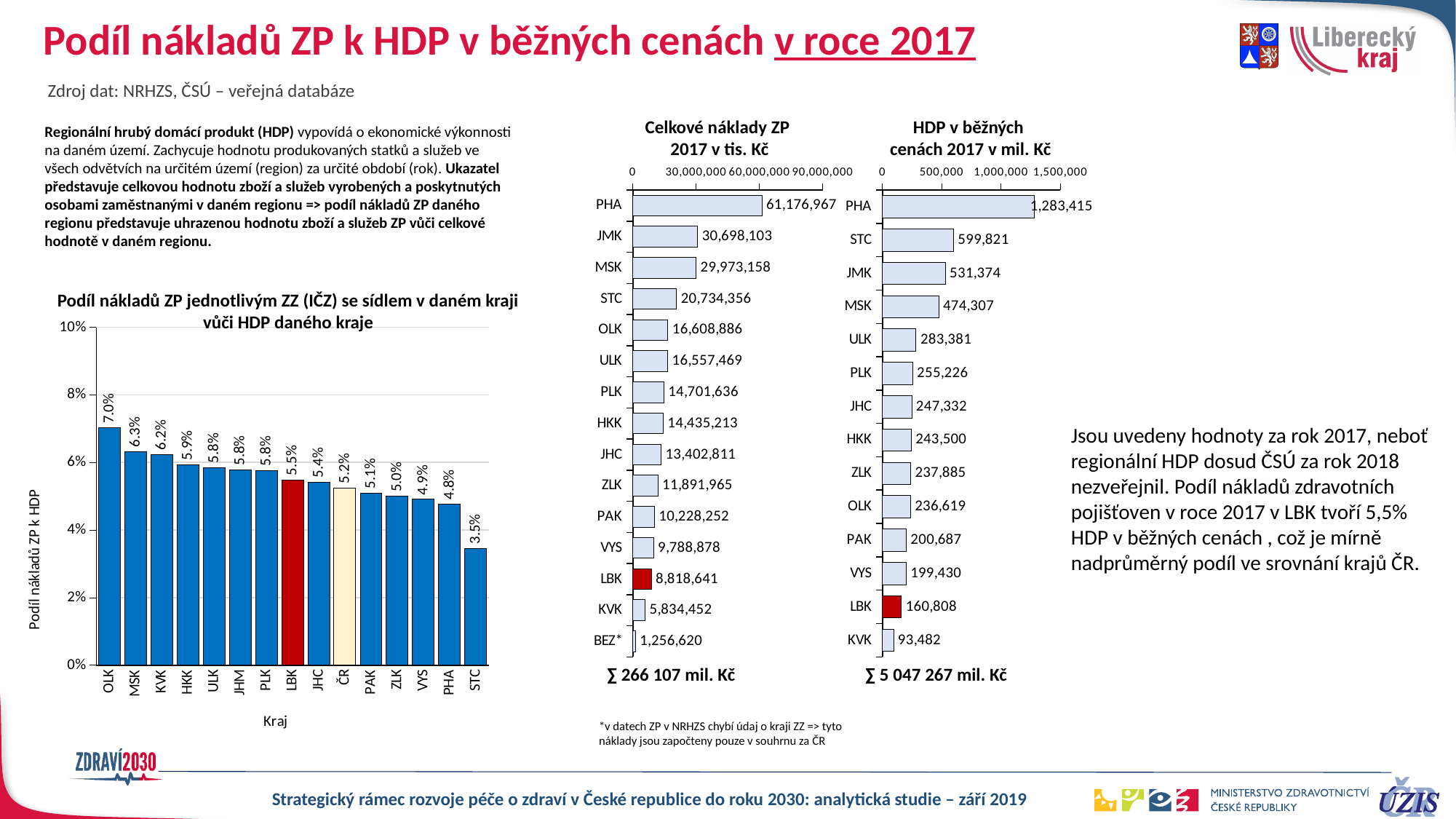
In the chart 'HDP v běžných cenách 2017 v mil. Kč', what is the value for STC? 599,821 In the chart 'Celkové náklady ZP 2017 v tis. Kč', which category has the highest value? PHA In the chart 'Celkové náklady ZP 2017 v tis. Kč', what is the value for LBK? 8,818,641 In the chart 'Podíl nákladů ZP jednotlivým ZZ (IČZ) se sídlem v daném kraji vůči HDP daného kraje', how many bars are shown? 15 What kind of chart is 'Celkové náklady ZP 2017 v tis. Kč'? Bar chart In the chart 'Podíl nákladů ZP jednotlivým ZZ (IČZ) se sídlem v daném kraji vůči HDP daného kraje', which kraj has the highest value? OLK In the chart 'Celkové náklady ZP 2017 v tis. Kč', which is larger, the value for JMK or the value for MSK? JMK In the chart 'Podíl nákladů ZP jednotlivým ZZ (IČZ) se sídlem v daném kraji vůči HDP daného kraje', what is the difference between the values for OLK and STC? 3.5% In the chart 'HDP v běžných cenách 2017 v mil. Kč', what is the difference between the values for PHA and STC? 683,594 In the chart 'Podíl nákladů ZP jednotlivým ZZ (IČZ) se sídlem v daném kraji vůči HDP daného kraje', which kraj has the lowest value? STC In the chart 'Podíl nákladů ZP jednotlivým ZZ (IČZ) se sídlem v daném kraji vůči HDP daného kraje', what is the value for LBK? 5.5% In the chart 'HDP v běžných cenách 2017 v mil. Kč', which category has the lowest value? KVK